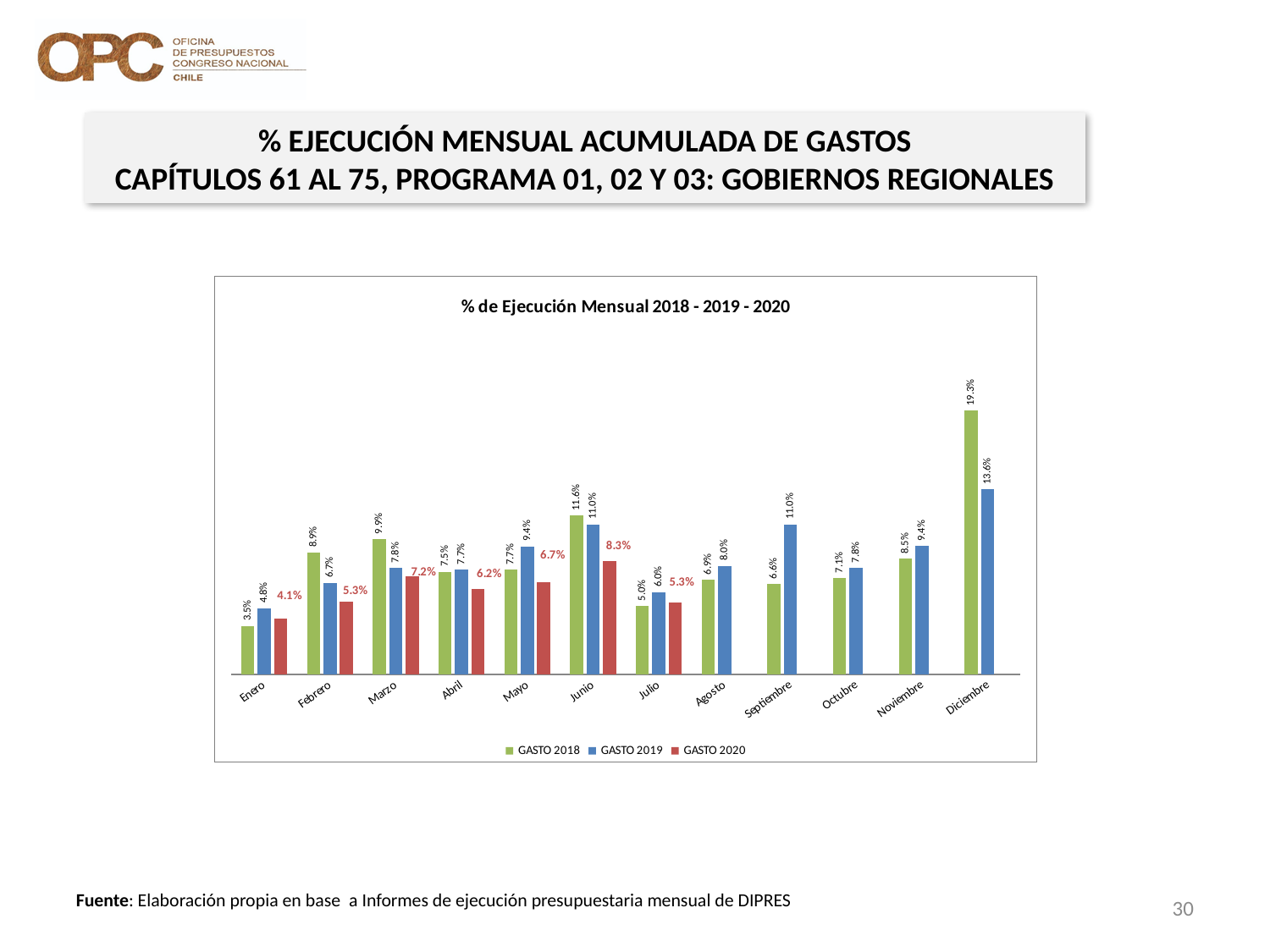
How many months are shown on the x axis? 12 What is the value for GASTO 2020 in Junio? 8.3% What is the title of the chart? % de Ejecución Mensual 2018 - 2019 - 2020 What is the value for GASTO 2018 in Diciembre? 19.3% What is the difference between GASTO 2018 and GASTO 2019 in Diciembre? 5.7% For how many months is a GASTO 2020 value shown? 7 What type of chart is shown on the slide? Bar chart How many series does the legend list? 3 What is the value for GASTO 2019 in Septiembre? 11.0% Which month has the highest value for GASTO 2019? Diciembre Which month has the lowest value for GASTO 2018? Enero Which is larger in Marzo, GASTO 2018 or GASTO 2019? GASTO 2018